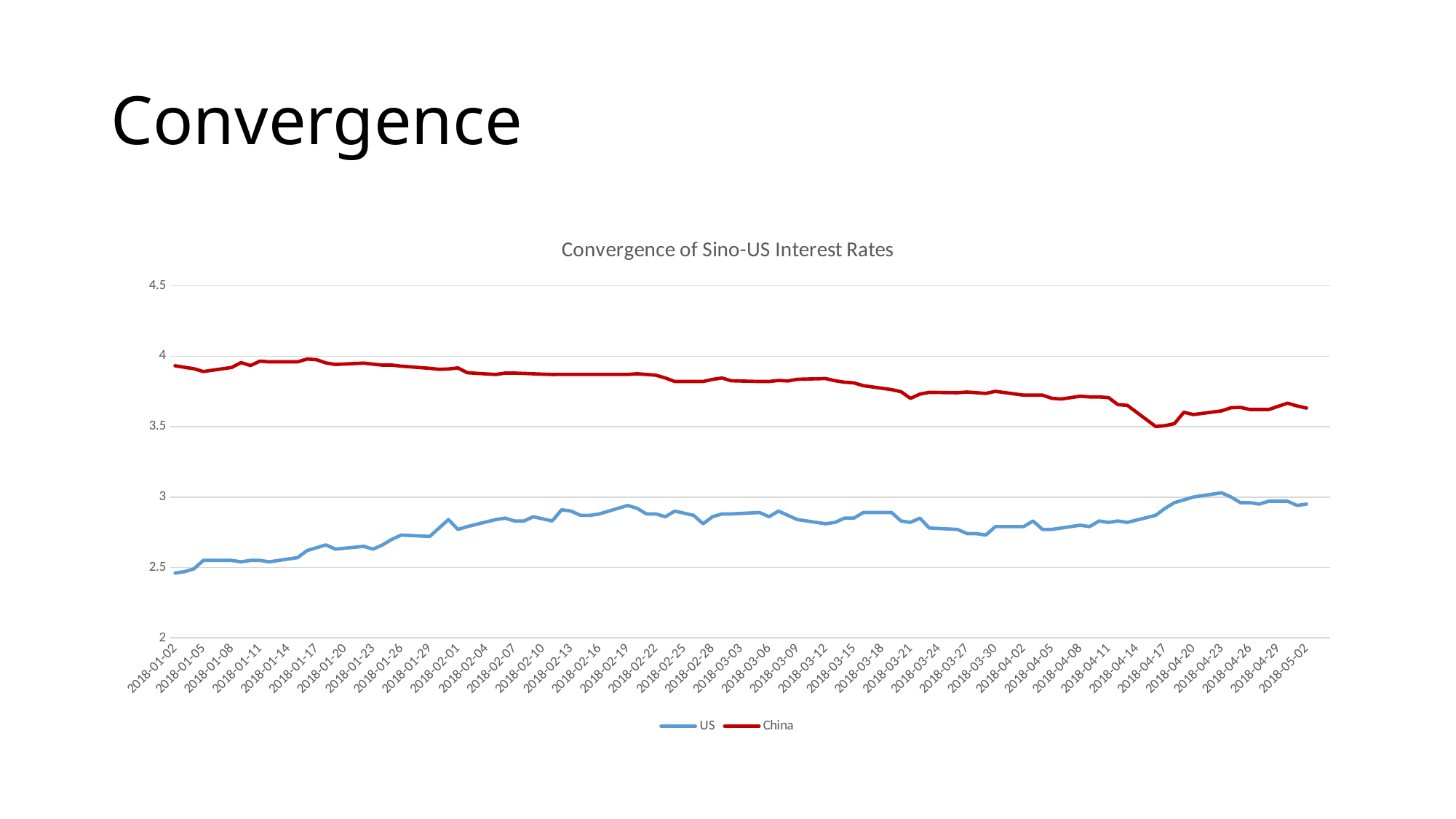
Is the value for China at 2018-05-02 greater or less than 4? less Which colour is used for the China series? red What is the title of the chart? Convergence of Sino-US Interest Rates Is the value for US at 2018-02-19 greater or less than 3? less Is the value for China at 2018-01-17 greater or less than 3.5? greater Which series has the higher value at 2018-01-02, US or China? China For the China series, which is larger: the value at 2018-01-17 or the value at 2018-04-17? 2018-01-17 What kind of chart is shown on the slide? line chart How many series does the legend list? 2 Does the US series generally rise or fall from 2018-01-02 to 2018-05-02? rise Does the China series generally rise or fall from 2018-01-02 to 2018-05-02? fall